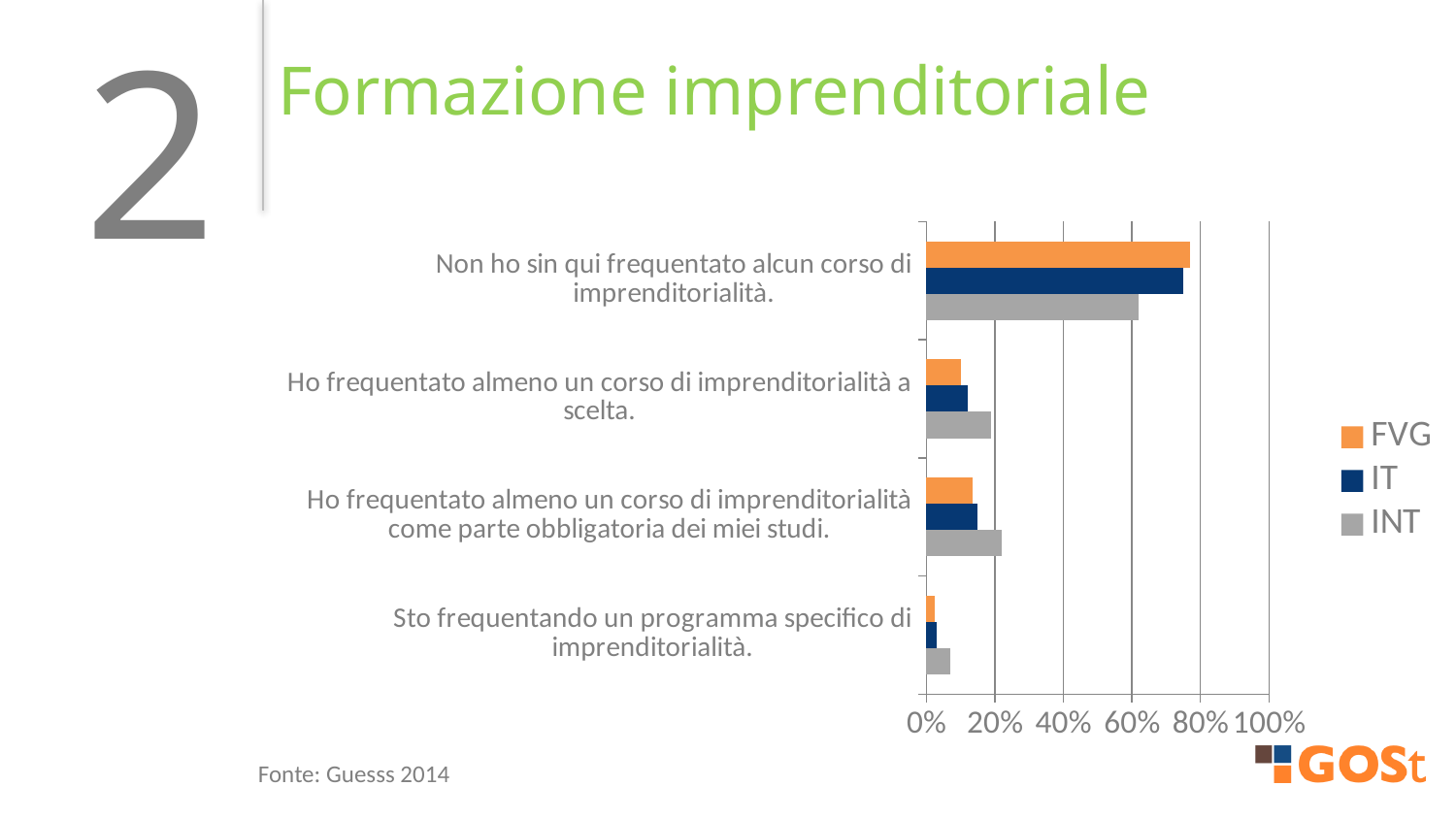
What kind of chart is shown on the slide? bar chart Which category has the highest values across all three series? Non ho sin qui frequentato alcun corso di imprenditorialità. For 'Ho frequentato almeno un corso di imprenditorialità come parte obbligatoria dei miei studi', which series has the largest value? INT Is the FVG value for 'Non ho sin qui frequentato alcun corso di imprenditorialità' greater or less than 60%? greater How many series does the legend list? 3 Which category has the lowest values across all three series? Sto frequentando un programma specifico di imprenditorialità. Which colour represents the INT series? grey For 'Non ho sin qui frequentato alcun corso di imprenditorialità', which is larger: the FVG value or the INT value? FVG Which series are listed in the legend? FVG, IT, INT How many categories are plotted in the chart? 4 Is the INT value for 'Non ho sin qui frequentato alcun corso di imprenditorialità' greater or less than 80%? less